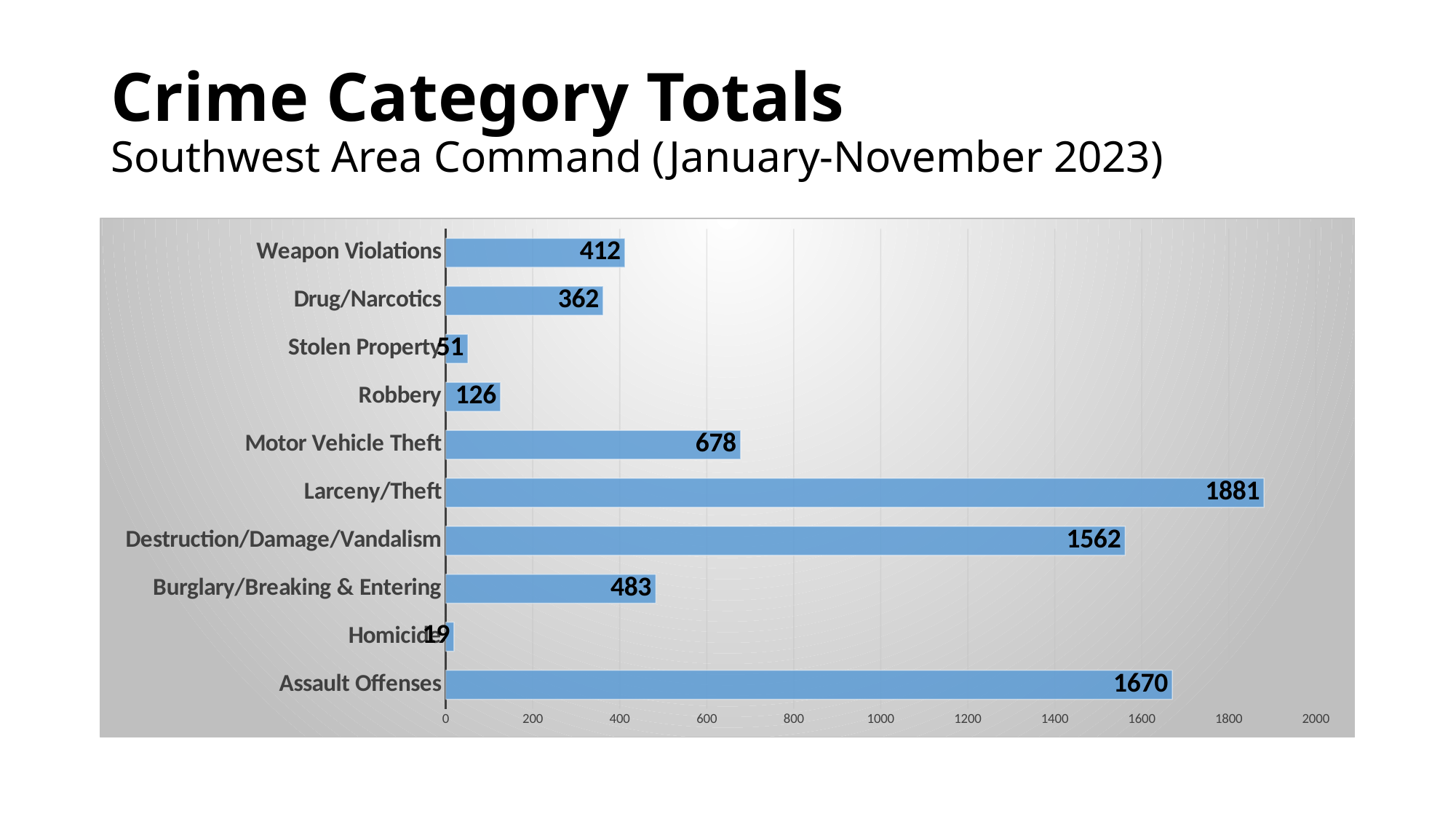
What is the value for Larceny/Theft? 1881 What is the difference between the values for Weapon Violations and Drug/Narcotics? 50 What kind of chart is shown on the slide? bar chart Is the value for Destruction/Damage/Vandalism greater or less than 1400? greater What is the value for Motor Vehicle Theft? 678 What is the difference between the values for Larceny/Theft and Assault Offenses? 211 Which is larger, the value for Burglary/Breaking & Entering or the value for Weapon Violations? Burglary/Breaking & Entering What is the title of the slide? Crime Category Totals What is the value for Robbery? 126 Which category has the highest value? Larceny/Theft Which category has the lowest value? Homicide How many categories are shown in the chart? 10